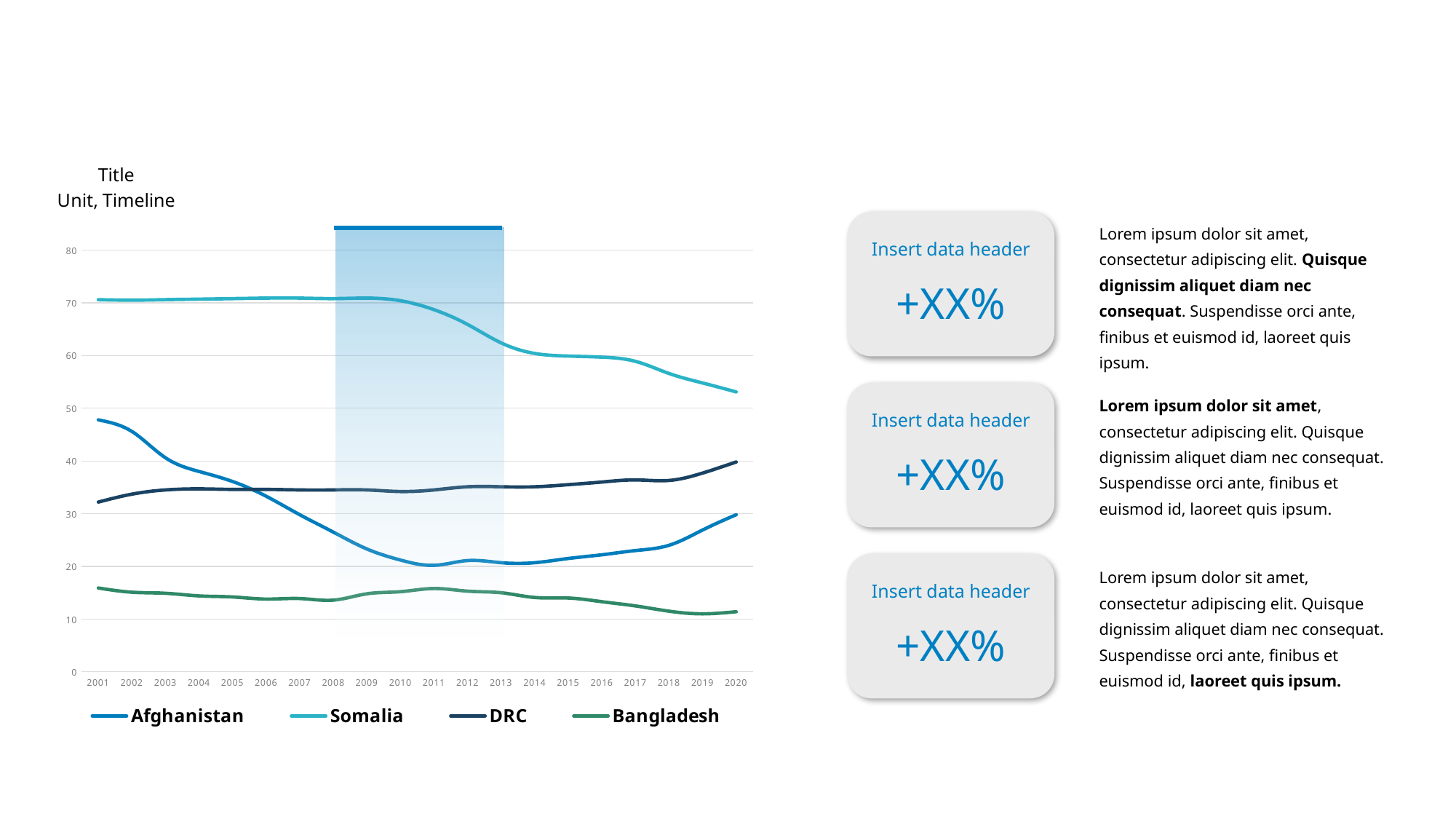
Which years does the shaded highlight band on the chart cover? 2008 to 2013 In 2001, which is larger: the value for Afghanistan or the value for DRC? Afghanistan Which series has the highest value in 2020? Somalia Is the value for Afghanistan in 2001 greater or less than 50? less What kind of chart is shown on the slide? line chart Is the value for Somalia in 2020 greater or less than 50? greater Does the Somalia line rise or fall from 2001 to 2020? fall How many years are shown along the x axis? 20 How many series does the legend list? 4 Which series has the lowest value in 2001? Bangladesh In 2020, which is larger: the value for DRC or the value for Afghanistan? DRC Is the value for Bangladesh in 2001 greater or less than 20? less